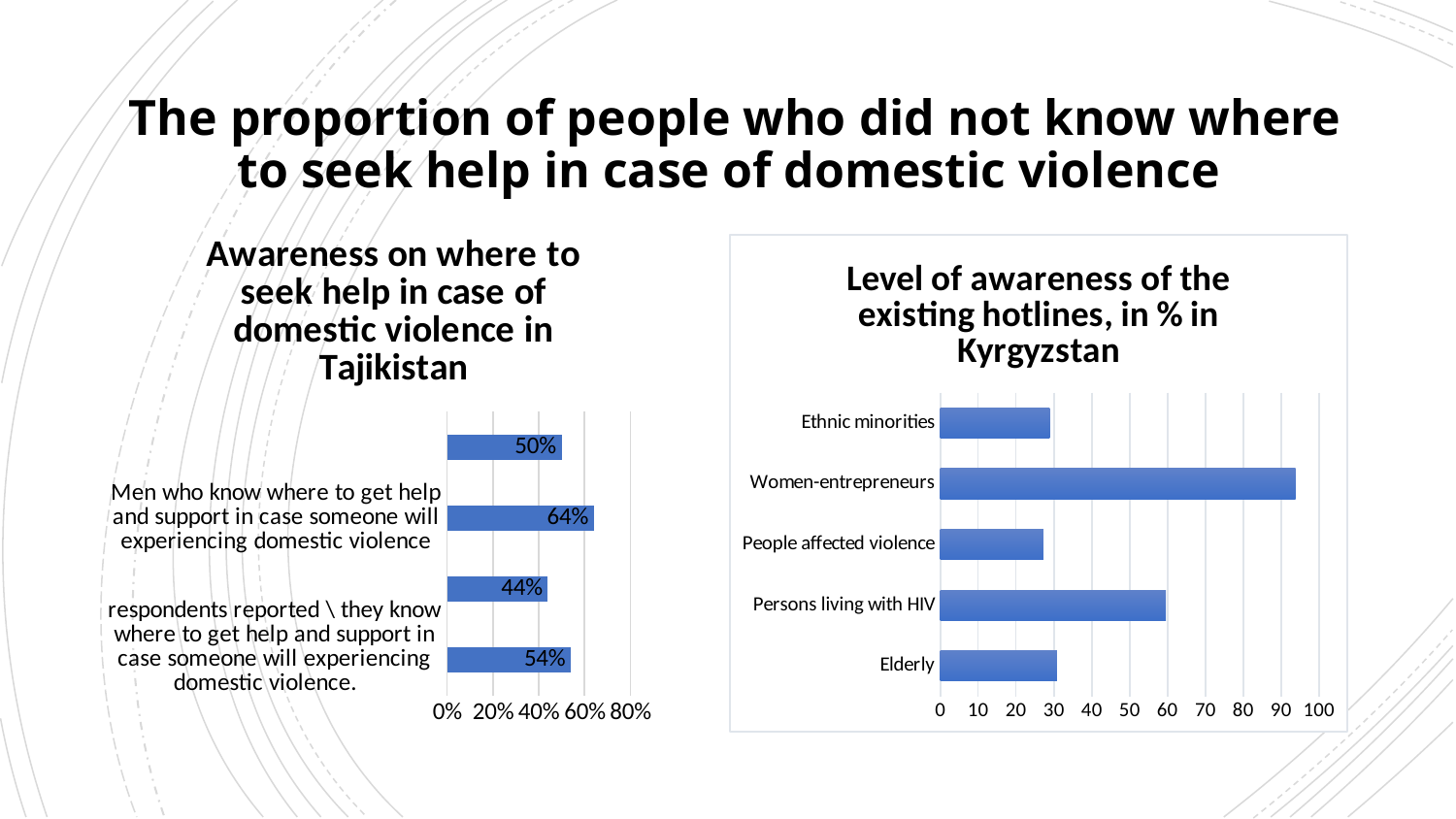
On the chart titled 'Level of awareness of the existing hotlines, in % in Kyrgyzstan', which category has the highest value? Women-entrepreneurs On the Kyrgyzstan chart on the right, which is larger: the value for Persons living with HIV or the value for Elderly? Persons living with HIV On the Kyrgyzstan chart on the right, is the value for Elderly greater or less than 20? greater What is the highest tick value shown on the x axis of the Tajikistan chart on the left? 80% On the Tajikistan chart on the left, what is the lowest value shown on a bar? 44% On the Tajikistan chart on the left, what is the highest value shown on a bar? 64% On the Kyrgyzstan chart on the right, is the value for Persons living with HIV greater or less than 50? greater How many bars are plotted on the Tajikistan chart on the left? 4 On the Kyrgyzstan chart on the right, is the value for Ethnic minorities greater or less than 40? less How many categories are shown on the chart titled 'Level of awareness of the existing hotlines, in % in Kyrgyzstan'? 5 What kind of chart is the Kyrgyzstan chart on the right? bar chart